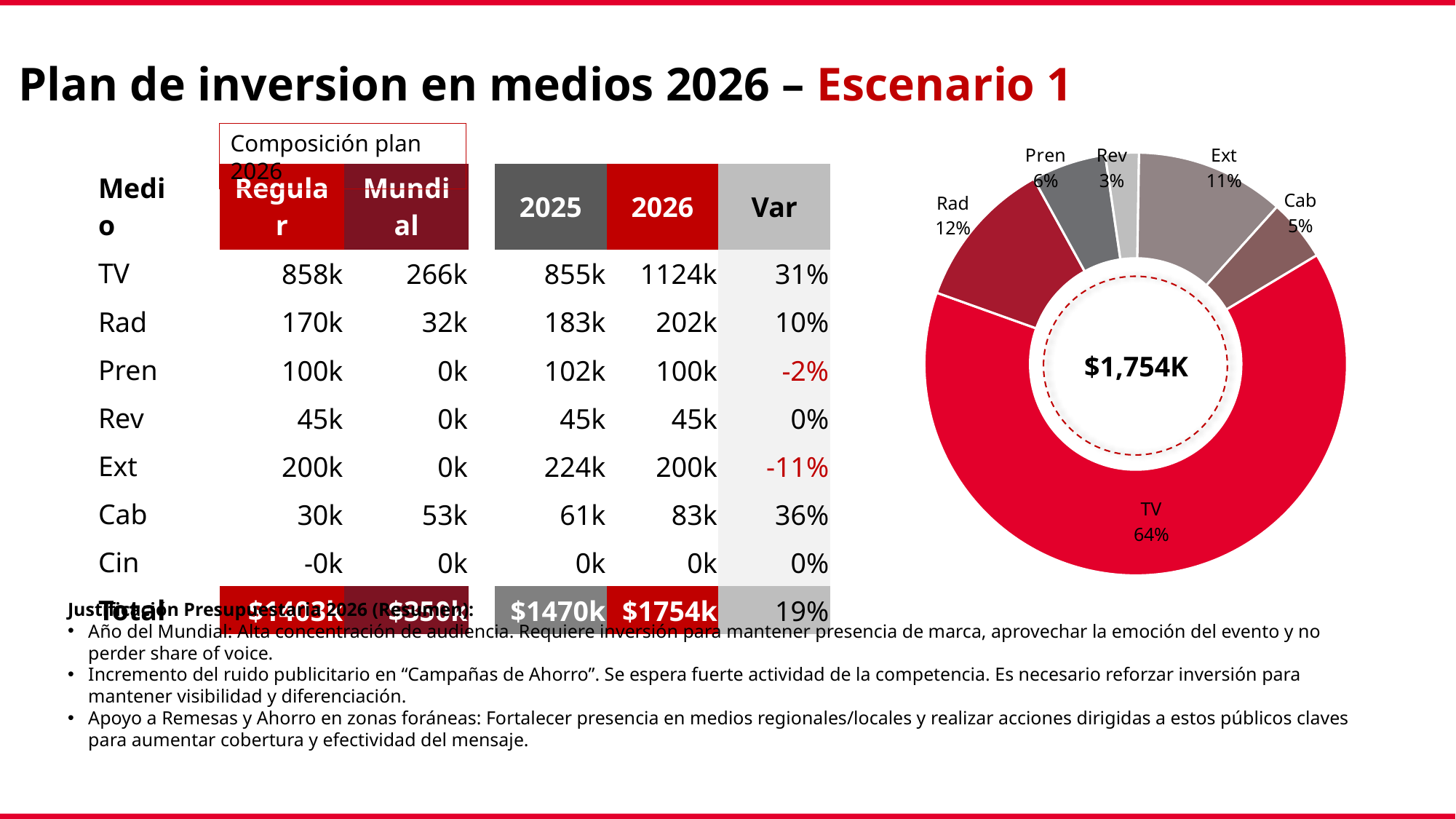
In the doughnut chart, what share does Cab have? 5% In the doughnut chart, which is larger, the Rad slice or the Ext slice? Rad In the doughnut chart, what is the difference in percentage points between the TV slice and the Rad slice? 52 In the doughnut chart, what share does Rev have? 3% What total value is shown in the centre of the doughnut chart? $1,754K Which labelled slice of the doughnut chart is the smallest? Rev In the doughnut chart, what share does Ext have? 11% In the doughnut chart, what share does Pren have? 6% What kind of chart is shown on the right of the slide? Doughnut chart Which slice of the doughnut chart is the largest? TV In the doughnut chart, what share does Rad have? 12% In the doughnut chart, what share does TV have? 64%